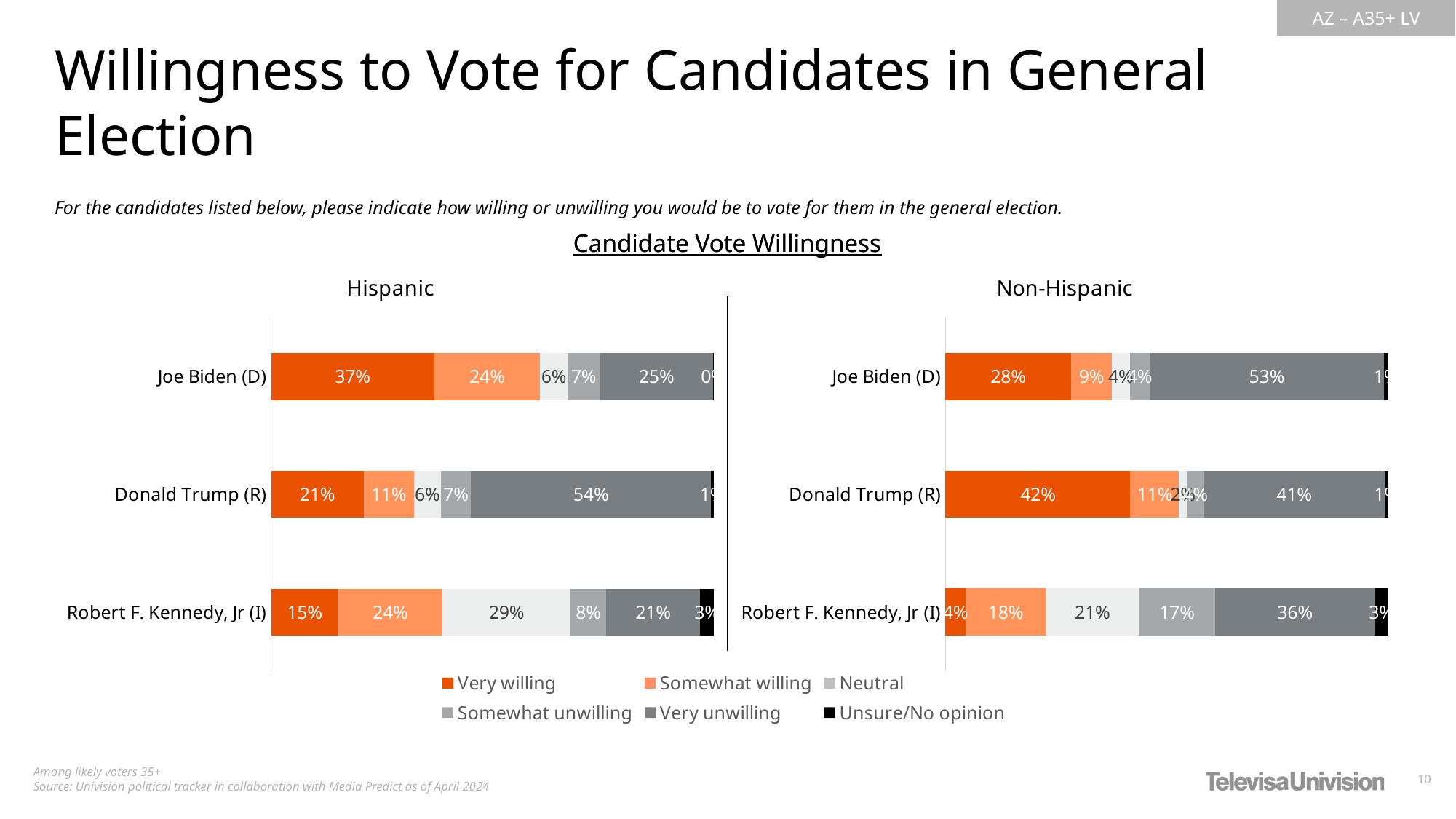
How many series does the legend list? 6 In the Hispanic chart, which candidate has the highest very unwilling percentage? Donald Trump (R) In the Hispanic chart, what percentage of respondents are very willing to vote for Joe Biden (D)? 37% In the Non-Hispanic chart, what percentage of respondents are very willing to vote for Donald Trump (R)? 42% In the Non-Hispanic chart, which candidate has the lowest very willing percentage? Robert F. Kennedy, Jr (I) How many candidates are shown in the Hispanic chart? 3 In the Hispanic chart, what is the difference between the very willing percentages for Joe Biden (D) and Donald Trump (R)? 16% What kind of chart is the Non-Hispanic chart? Stacked bar chart In the Hispanic chart, what percentage of respondents are neutral about voting for Robert F. Kennedy, Jr (I)? 29% In the Non-Hispanic chart, what is the combined very willing and somewhat willing percentage for Robert F. Kennedy, Jr (I)? 22% In the Non-Hispanic chart, is the very unwilling percentage larger for Joe Biden (D) or Robert F. Kennedy, Jr (I)? Joe Biden (D) In the Non-Hispanic chart, what percentage of respondents are very unwilling to vote for Joe Biden (D)? 53%